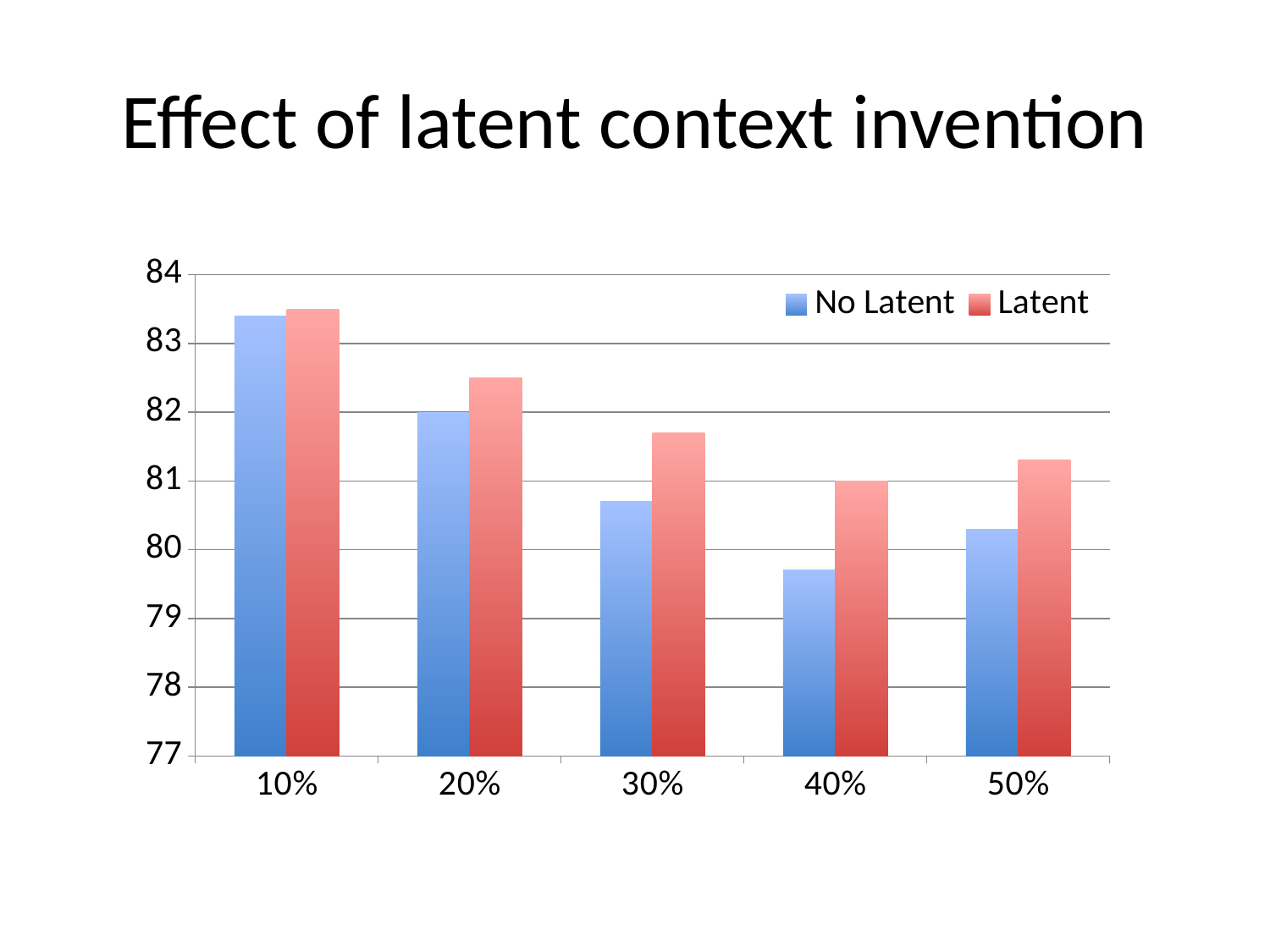
At which category is the No Latent value lowest? 40% Which series is shown in red? Latent Is the No Latent value at 40% greater or less than 80? less Is the No Latent value at 30% greater or less than 81? less Is the Latent value at 20% greater or less than 82? greater What is the title of the chart? Effect of latent context invention At which category is the Latent value highest? 10% How many series does the legend list? 2 What kind of chart is shown on the slide? bar chart At 30%, which series has the larger value, No Latent or Latent? Latent How many categories are shown on the x axis? 5